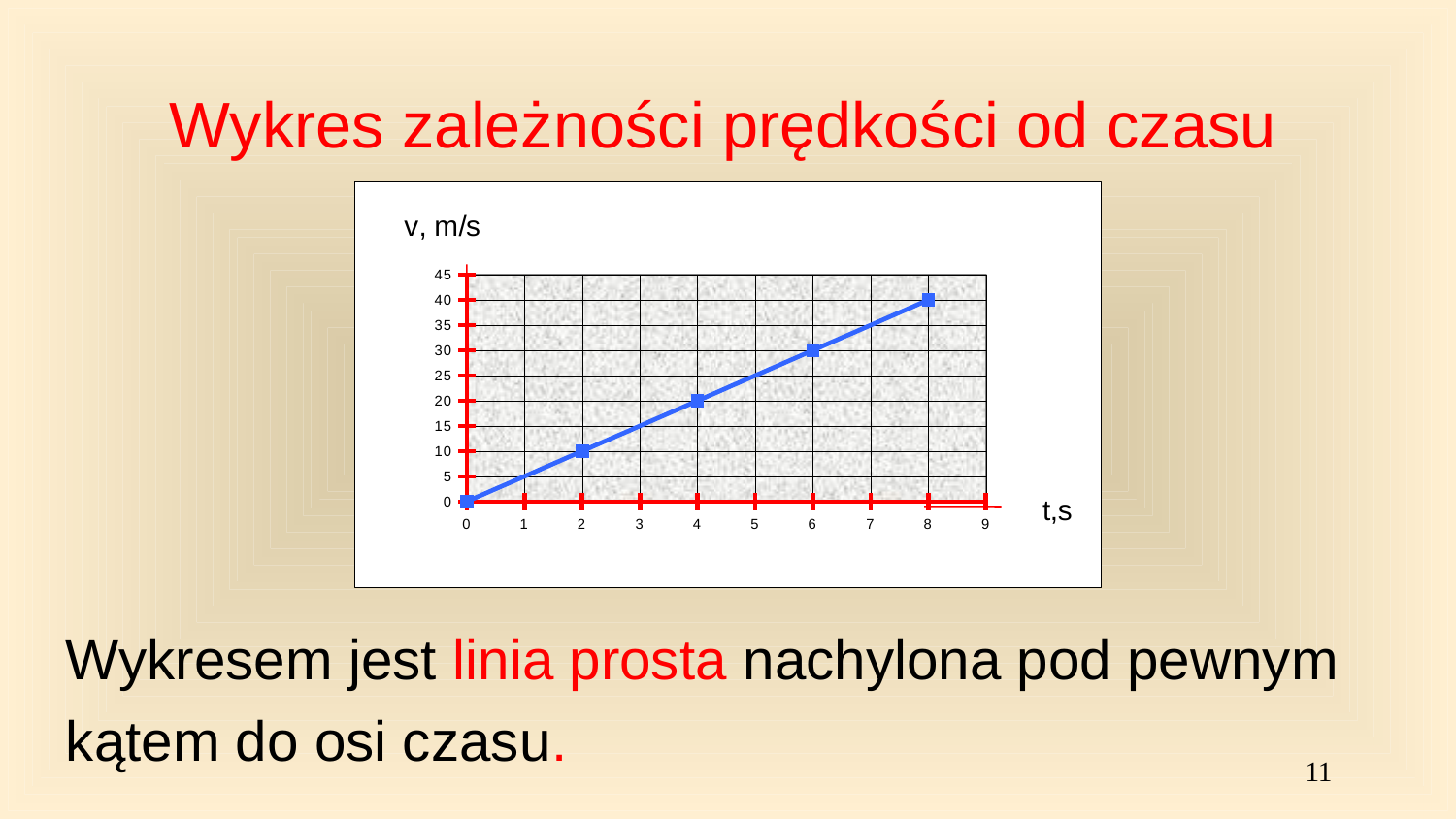
At which value of t is v lowest? 0 What is the value of v at t = 2 s? 10 What is the value of v at t = 8 s? 40 What kind of chart is shown on the slide? line chart What is the value of v at t = 4 s? 20 What is the value of v at t = 6 s? 30 How many data points are plotted on the line? 5 What is the label of the vertical axis? v, m/s Do the values of v rise or fall as t increases? rise At which value of t is v highest? 8 Which is larger: v at t = 6 s or v at t = 4 s? v at t = 6 s What is the difference between v at t = 8 s and v at t = 2 s? 30